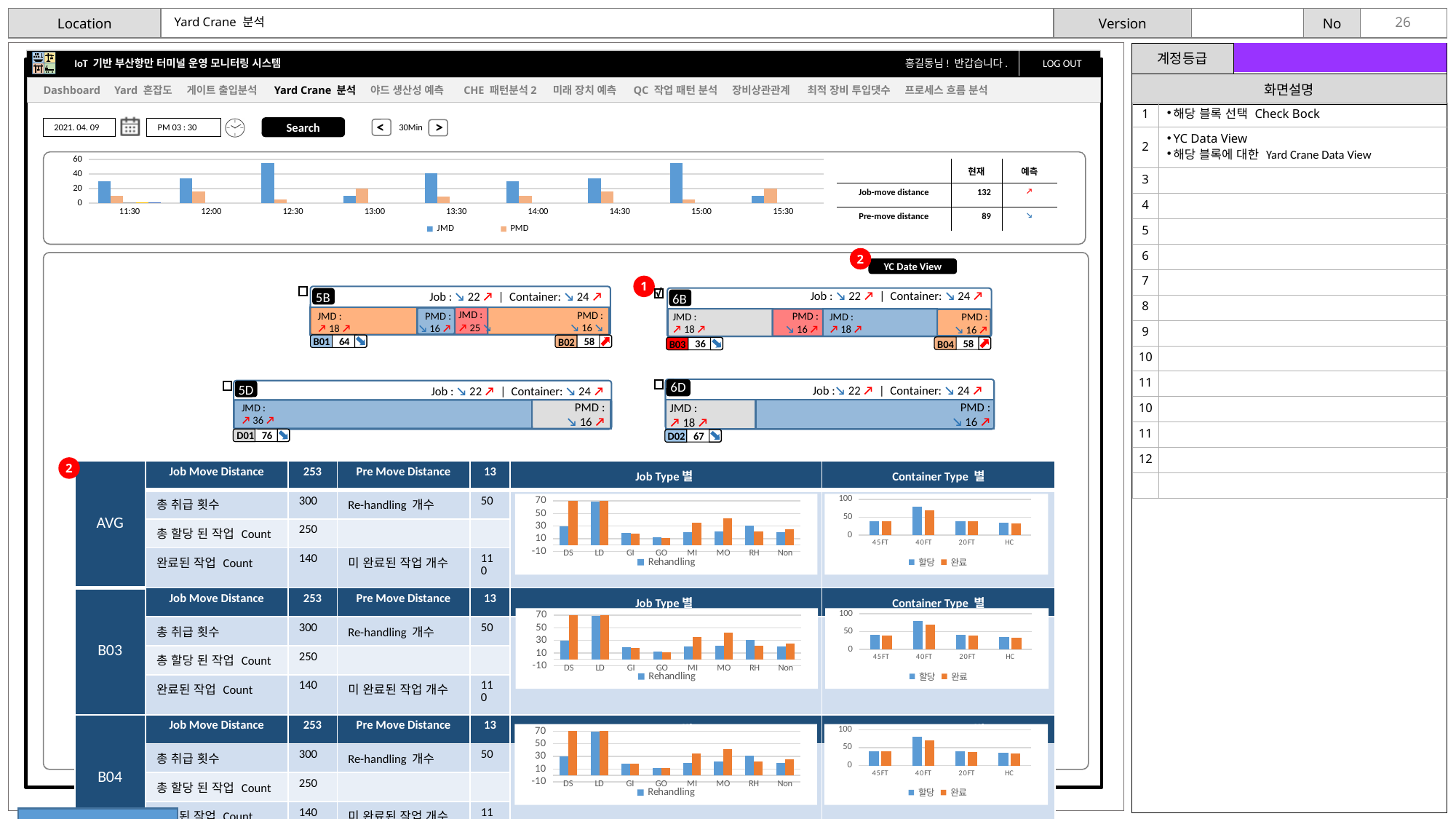
In the top JMD/PMD chart, what are the two legend entries? JMD, PMD How many categories are on the x axis of the 'Job Type 별' chart in the AVG row? 8 In the top JMD/PMD chart, which is larger at 13:00, JMD or PMD? PMD How many categories are on the x axis of the 'Container Type 별' chart in the AVG row? 4 In the top JMD/PMD chart, is the JMD value at 12:30 greater or less than 40? greater How many series does the legend of the top JMD/PMD chart list? 2 In the 'Job Type 별' chart in the AVG row, is the blue bar for LD greater or less than 50? greater In the 'Container Type 별' chart in the AVG row, which category has the highest 할당 value? 40FT In the 'Container Type 별' chart in the AVG row, is the 할당 value for 45FT greater or less than 50? less What kind of chart is the chart at the top of the slide showing JMD and PMD over time? bar chart How many time points are shown on the x axis of the top JMD/PMD chart? 9